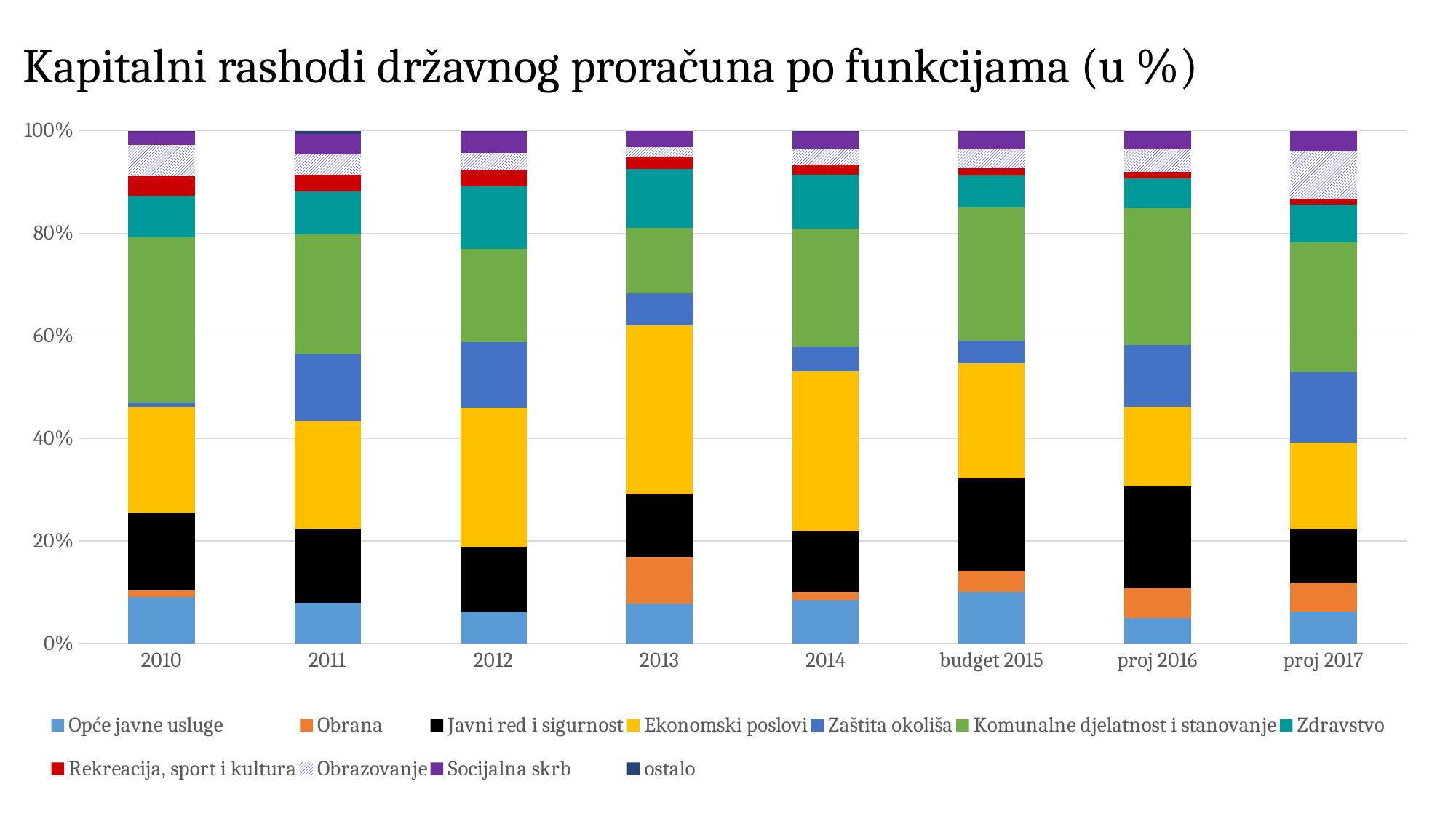
How many series does the legend list? 11 What does each stacked bar total? 100% In which year is the Komunalne djelatnost i stanovanje segment the smallest? 2013 How many years/periods are shown on the x axis of the chart? 8 Which is larger: the Zaštita okoliša share in proj 2017 or in 2010? proj 2017 In which year is the Obrana segment the largest? 2013 What is the title of the chart? Kapitalni rashodi državnog proračuna po funkcijama (u %) Is the value for Opće javne usluge in proj 2016 greater or less than 10%? less What kind of chart is shown on the slide? Stacked bar chart Is the value for Opće javne usluge in 2012 greater or less than 10%? less Which is larger: the Komunalne djelatnost i stanovanje share in 2010 or in 2013? 2010 Which is larger: the Ekonomski poslovi share in 2013 or in 2010? 2013